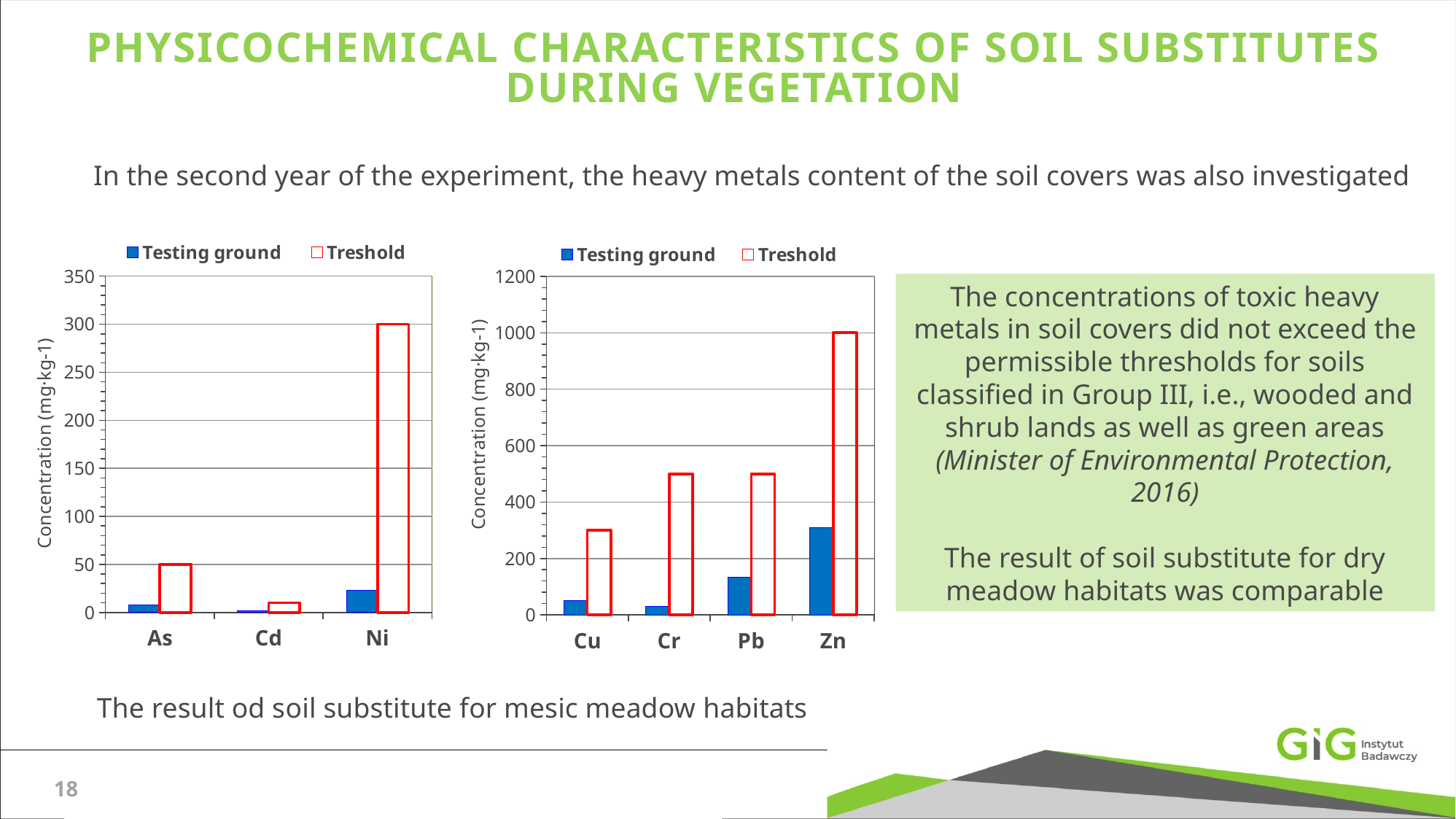
On the right chart (Cu, Cr, Pb, Zn), which is larger, the Testing ground value for Pb or for Cr? Pb On the right chart (Cu, Cr, Pb, Zn), is the Testing ground value for Pb greater or less than 200? less On the left chart (As, Cd, Ni), which category has the highest Treshold value? Ni On the right chart (Cu, Cr, Pb, Zn), what is the Treshold value for Zn? 1000 On the left chart (As, Cd, Ni), is the Testing ground value for Ni greater or less than 50? less On the left chart (As, Cd, Ni), what is the Treshold value for As? 50 On the right chart (Cu, Cr, Pb, Zn), is the Testing ground value for Zn greater or less than 200? greater On the left chart (As, Cd, Ni), what is the Treshold value for Ni? 300 How many categories are shown on the right chart (Cu, Cr, Pb, Zn)? 4 On the right chart (Cu, Cr, Pb, Zn), which category has the highest Testing ground value? Zn On the left chart (As, Cd, Ni), which category has the lowest Testing ground value? Cd How many series does the legend of the left chart (As, Cd, Ni) list? 2